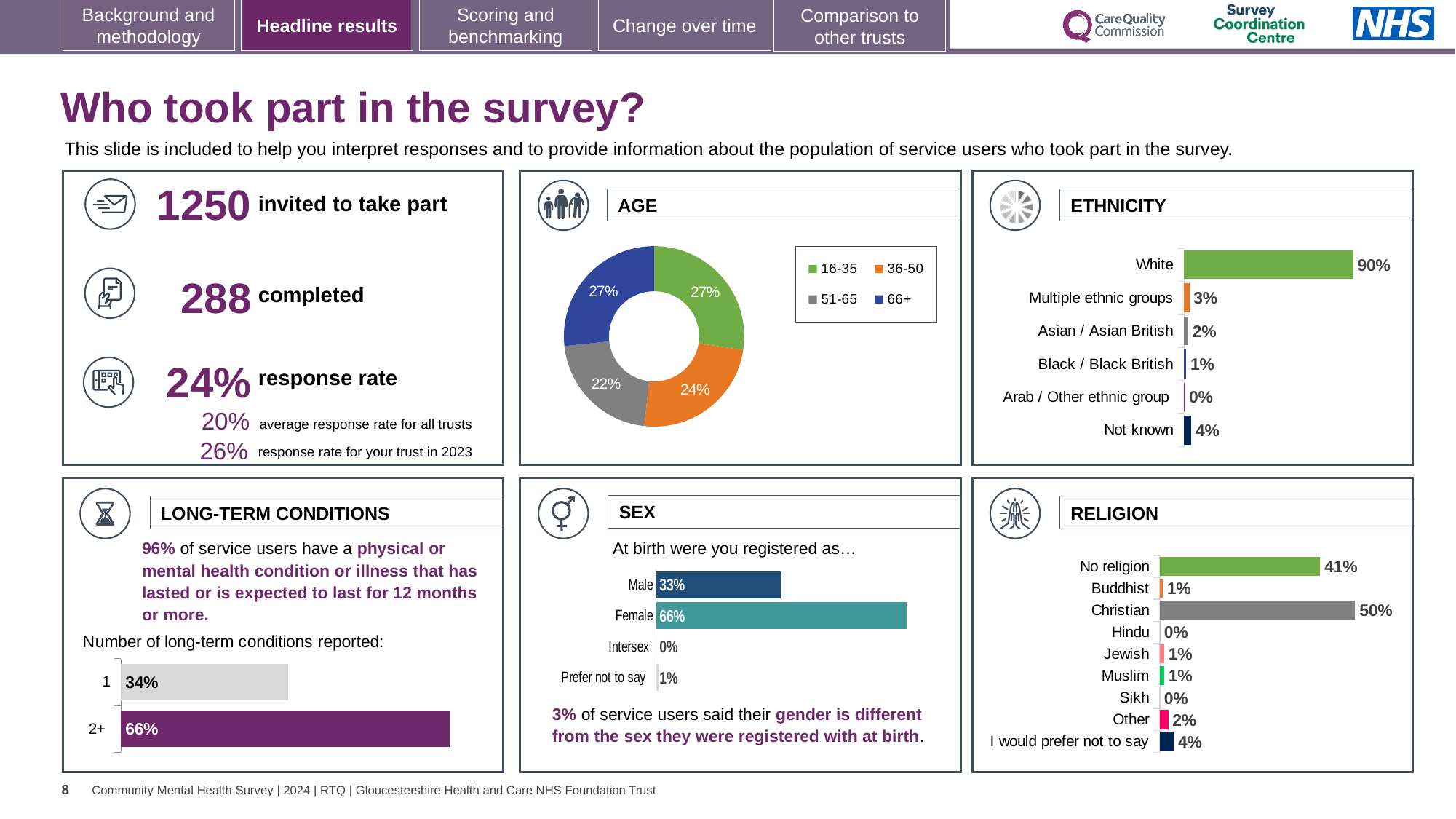
In the RELIGION chart, which category has the highest value? Christian In the SEX chart, which is larger, Male or Female? Female How many ethnicity categories are shown in the ETHNICITY chart? 6 In the AGE chart, what percentage of respondents were aged 36-50? 24% How many age groups does the legend of the AGE chart list? 4 In the LONG-TERM CONDITIONS chart, what percentage of service users reported 2+ conditions? 66% In the RELIGION chart, what is the difference between Christian and No religion? 9% In the ETHNICITY chart, what is the difference between White and Not known? 86% What kind of chart is the AGE chart? Donut (pie) chart In the ETHNICITY chart, what is the value for White? 90% In the AGE chart, which age group has the smallest share? 51-65 In the SEX chart, what is the value for Prefer not to say? 1%